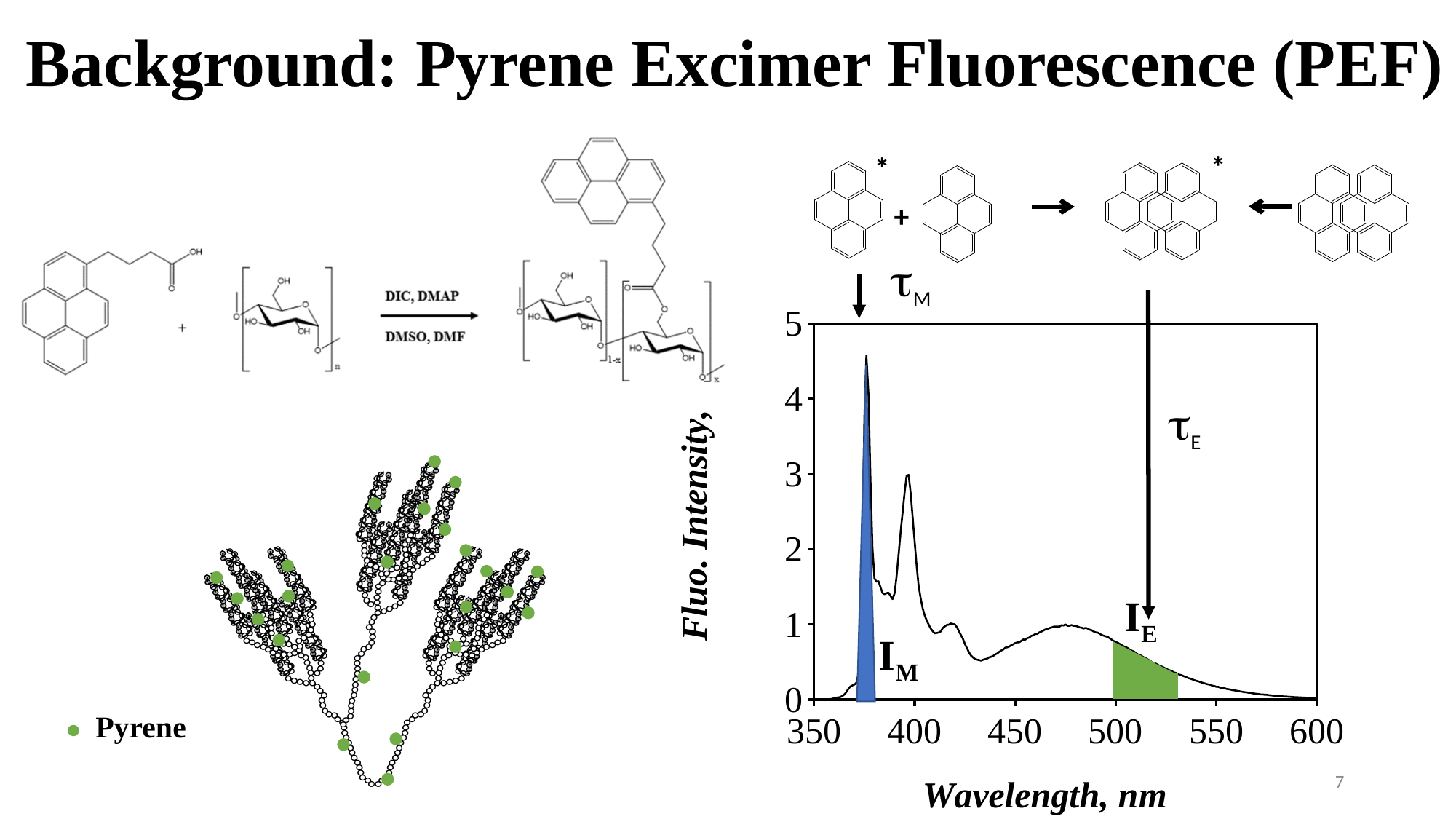
Is the fluorescence intensity at 500 nm greater or less than 1? less Is the fluorescence intensity at 600 nm greater or less than 1? less Is the fluorescence intensity at 550 nm greater or less than 1? less Which has the higher fluorescence intensity, 400 nm or 500 nm? 400 nm What kind of chart is shown on the right of the slide? line chart How many data series are plotted on the fluorescence chart? 1 Which has the higher fluorescence intensity, the peak near 375 nm or the peak near 400 nm? the peak near 375 nm What colour is the shaded region labelled I_E on the fluorescence chart? green Between 500 nm and 600 nm, does the fluorescence intensity rise or fall? fall What is the label of the x axis of the fluorescence chart? Wavelength, nm